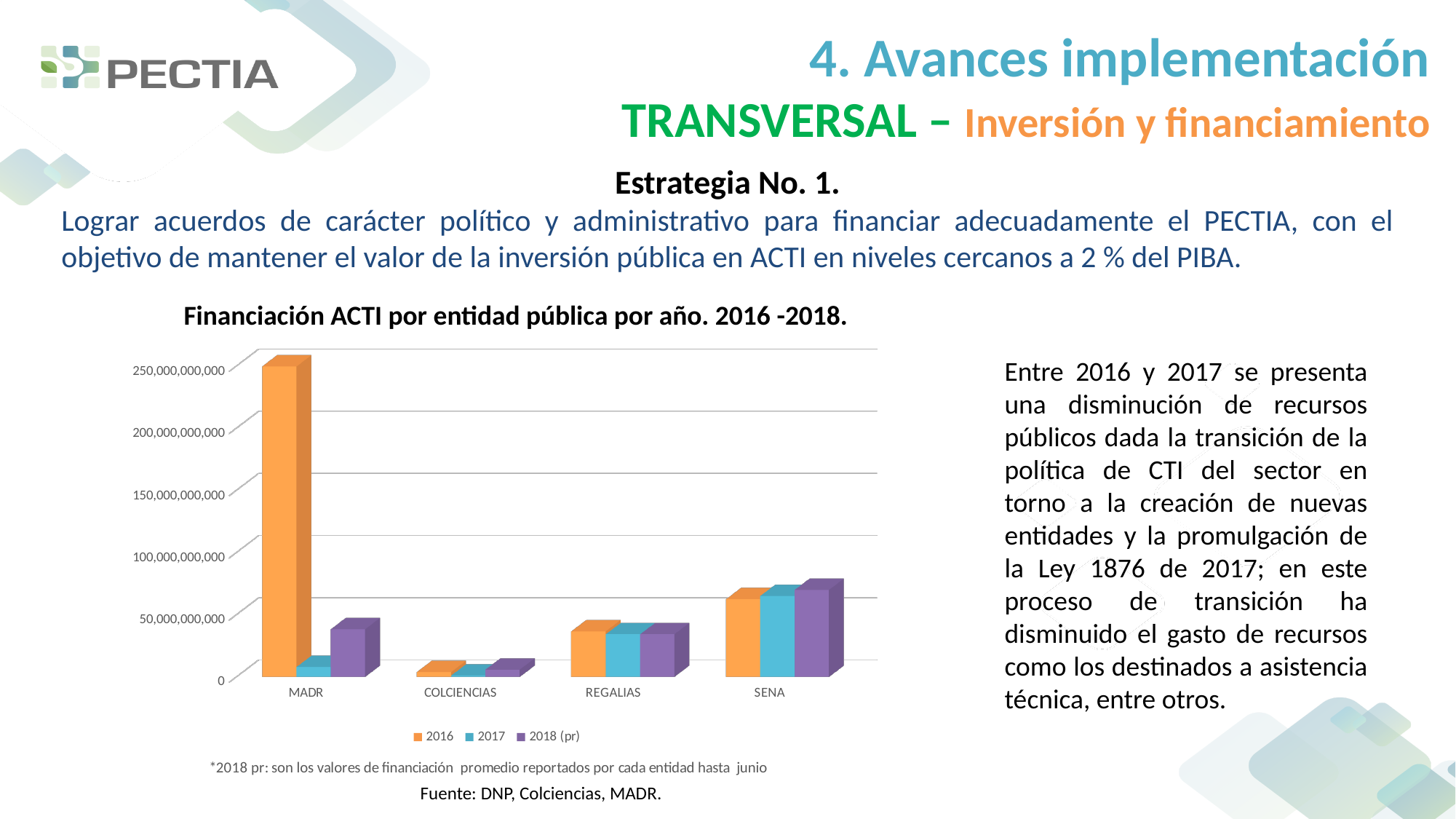
What kind of chart is shown on the slide? Bar chart How many entities (categories) are shown on the x axis of the chart? 4 Which entity has the highest 2016 value in the chart? MADR What is the title of the chart? Financiación ACTI por entidad pública por año. 2016 -2018. Which series is shown in orange in the chart? 2016 How many series does the chart legend list? 3 Which is larger for MADR: the 2017 value or the 2018 (pr) value? 2018 (pr) Is the 2016 value for COLCIENCIAS greater or less than 50,000,000,000? less Which entity has the lowest 2016 value in the chart? COLCIENCIAS Is the 2018 (pr) value for SENA greater or less than 50,000,000,000? greater Is the 2016 value for MADR greater or less than 200,000,000,000? greater Which entity has the larger 2018 (pr) value: REGALIAS or SENA? SENA